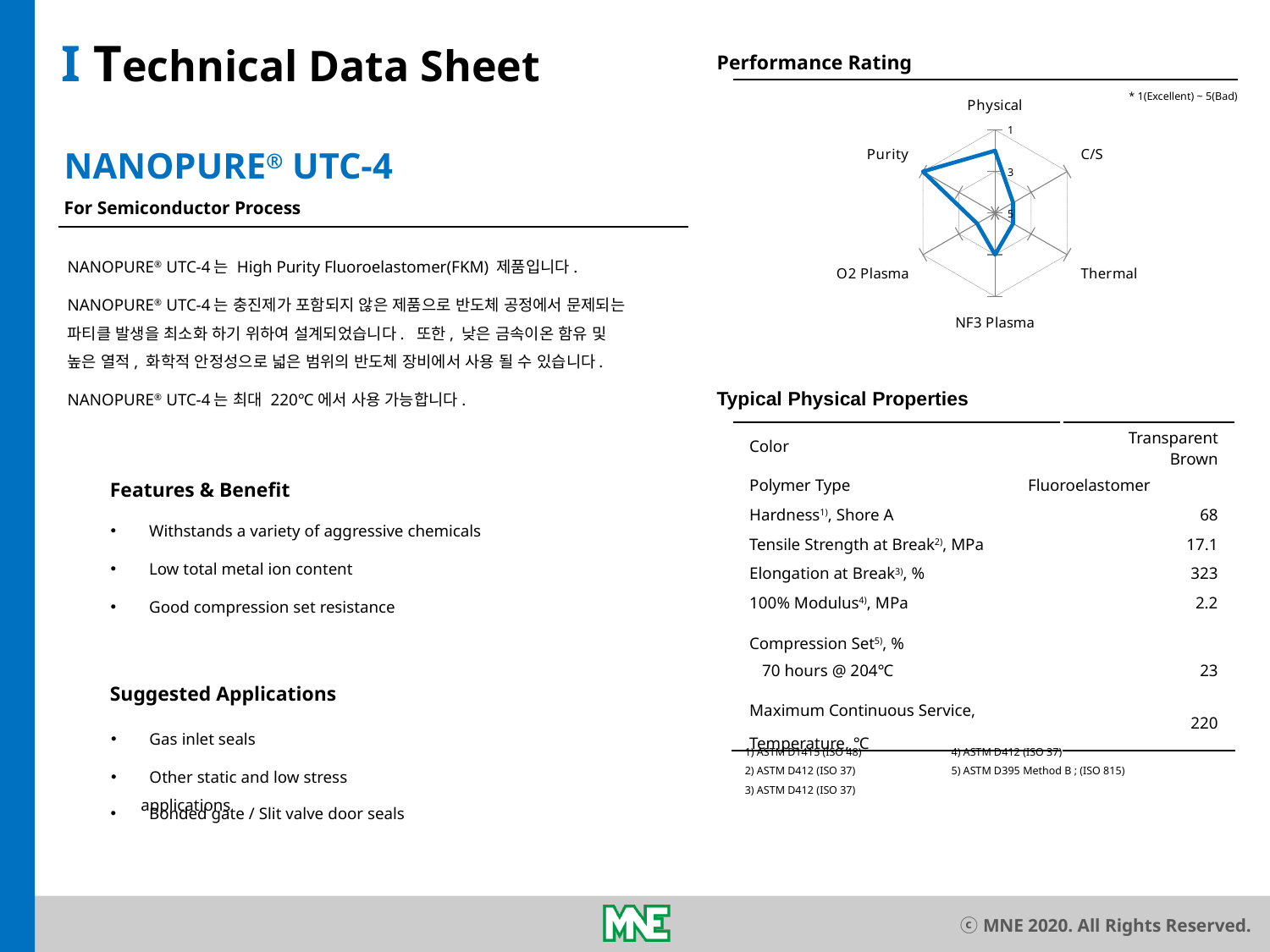
On the Performance Rating chart, is the plotted value for Physical larger or smaller than the value for Thermal? smaller On the Performance Rating chart, is the value for C/S greater or less than 3? greater What is the title of the chart on the slide? Performance Rating On the Performance Rating chart, is the value for Purity greater or less than 3? less On the Performance Rating chart, what rating value corresponds to 'Excellent' according to the note? 1 How many data series are plotted on the Performance Rating chart? 1 What kind of chart is the Performance Rating chart? radar chart How many categories (axes) does the Performance Rating radar chart have? 6 On the Performance Rating chart, is the value for O2 Plasma greater or less than 3? greater On the Performance Rating chart, is the plotted value for Purity larger or smaller than the value for C/S? smaller